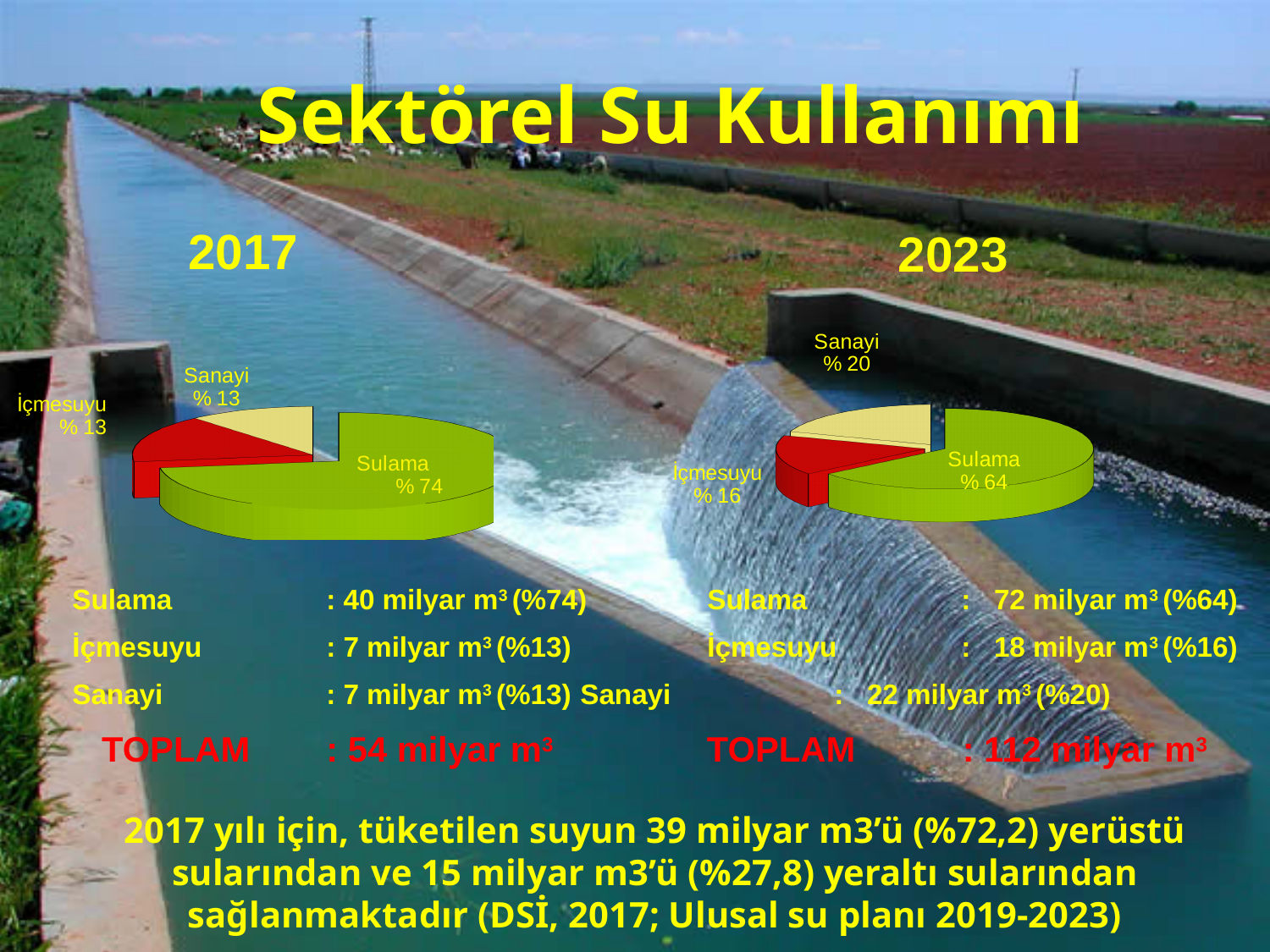
In the 2023 pie chart, which category has the smallest slice? İçmesuyu In the 2023 pie chart, what share does İçmesuyu have? % 16 In the 2023 pie chart, which category has the largest slice? Sulama In the 2023 pie chart, which is larger, Sanayi or İçmesuyu? Sanayi In the 2017 pie chart, what share does Sulama have? % 74 In the 2017 pie chart, what share does Sanayi have? % 13 What is the difference in percentage points between the Sulama share in the 2017 chart and the Sulama share in the 2023 chart? 10 What is the title of the slide containing the two pie charts? Sektörel Su Kullanımı In the 2023 pie chart, what share does Sulama have? % 64 How many slices does the 2017 pie chart have? 3 In the 2023 pie chart, what share does Sanayi have? % 20 What type of chart is used for the 2017 chart on the left? pie chart